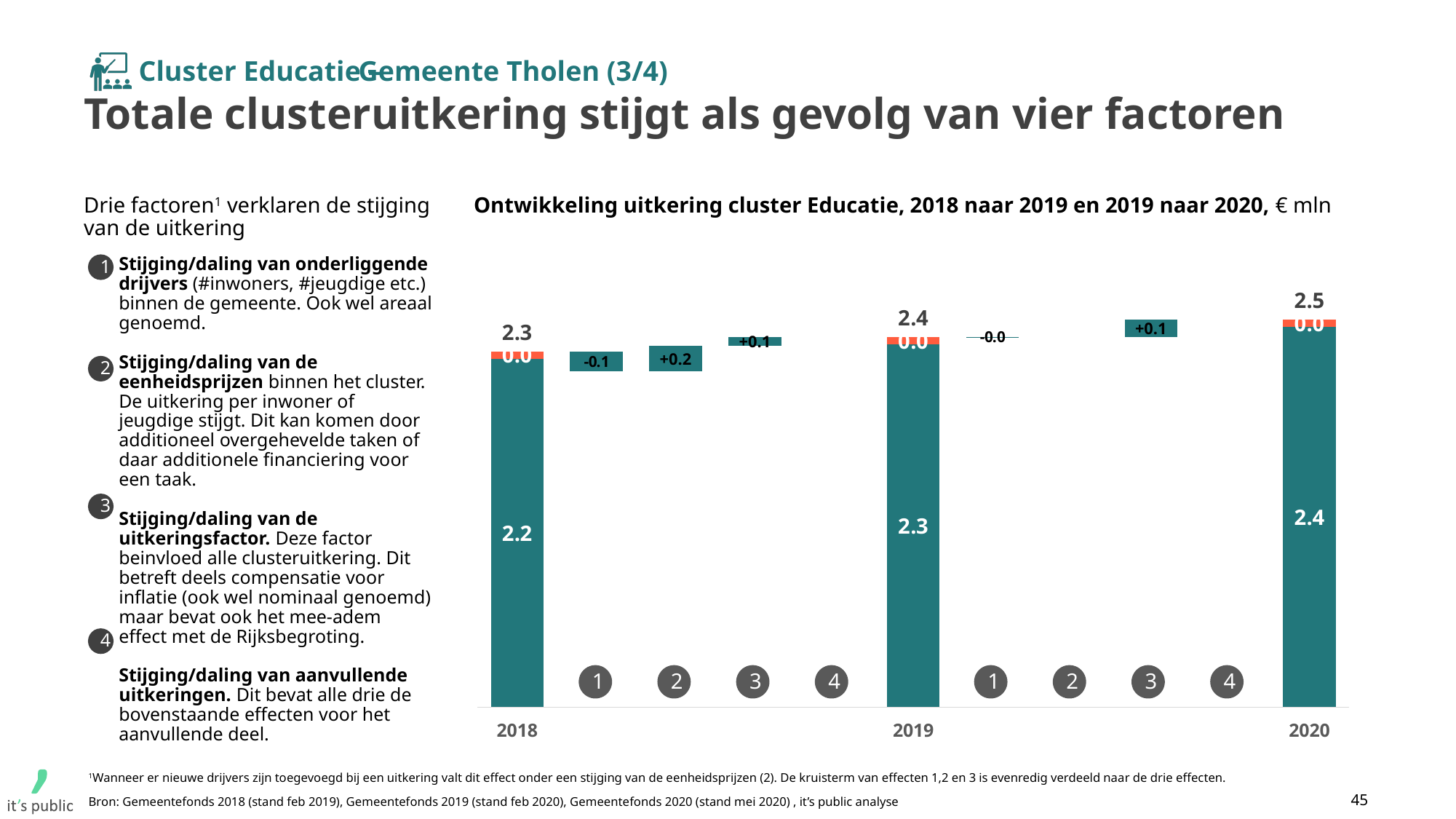
What is the total uitkering for cluster Educatie in 2018? 2.3 What is the value of the teal (main) segment of the 2019 bar? 2.3 By how much did the total uitkering increase from 2018 to 2020? 0.2 What is the effect of factor 3 (uitkeringsfactor) on the change from 2019 to 2020? +0.1 What is the total uitkering for cluster Educatie in 2020? 2.5 How many years are shown as total bars in the chart? 3 Which year has the highest total uitkering? 2020 In what unit are the values in the chart expressed? € mln What is the effect of factor 2 (eenheidsprijzen) on the change from 2018 to 2019? +0.2 Which year has the lowest total uitkering? 2018 What is the effect of factor 1 (onderliggende drijvers) on the change from 2018 to 2019? -0.1 Does the total uitkering rise or fall from 2018 to 2020? rise